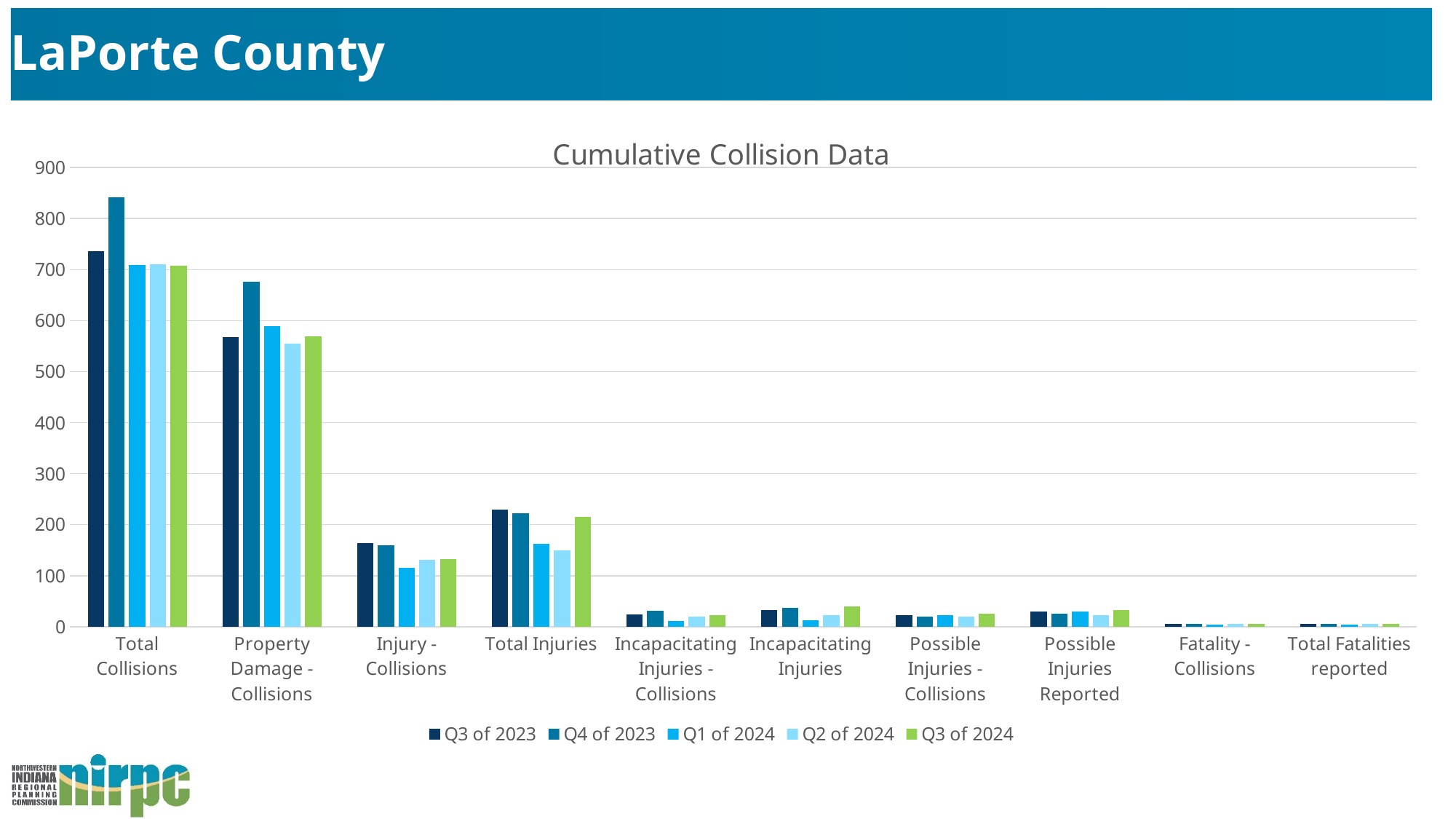
Is the Q3 of 2023 value for Property Damage - Collisions greater or less than 600? less How many series does the legend list? 5 For Total Collisions, which quarter has the highest bar? Q4 of 2023 Which is larger for Total Collisions: Q3 of 2023 or Q4 of 2023? Q4 of 2023 For Injury - Collisions, which quarter has the lowest bar? Q1 of 2024 What is the title of the chart? Cumulative Collision Data What kind of chart is shown on the slide? bar chart Which category has the tallest bars overall? Total Collisions Which is larger for Injury - Collisions: Q3 of 2023 or Q1 of 2024? Q3 of 2023 Is the Q3 of 2024 value for Total Injuries greater or less than 200? greater How many categories are shown along the x axis? 10 Is the Q4 of 2023 value for Total Collisions greater or less than 800? greater